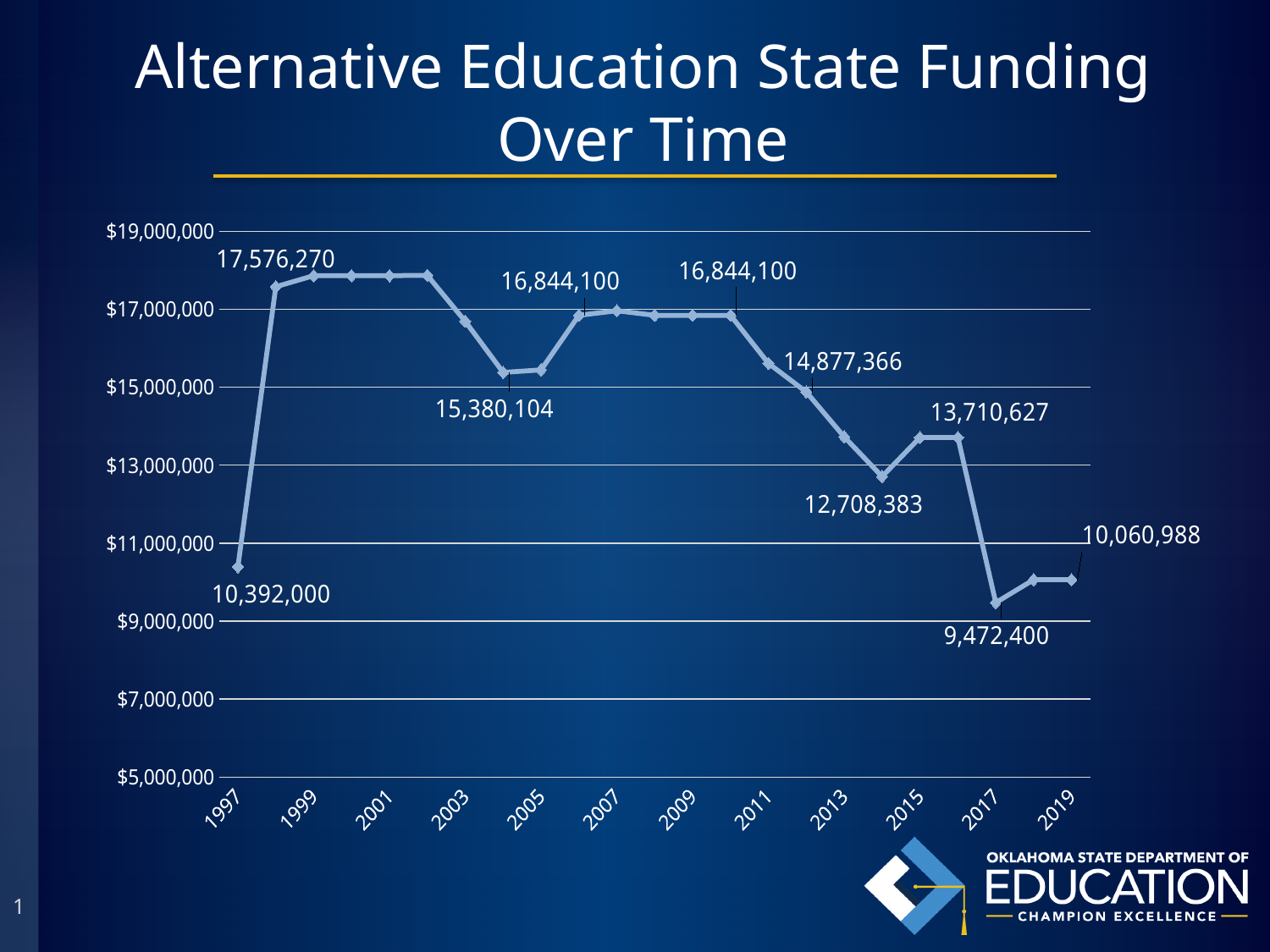
In which year does the funding reach its lowest point? 2017 What type of chart is shown on the slide? Line chart What is the difference between the 2019 value and the 2017 value? 588,588 What is the highest funding value labeled on the chart? 17,576,270 Is the value for 2013 greater or less than $15,000,000? less How many year labels are shown on the x axis? 12 What is the funding value for 2017? 9,472,400 What is the funding value for 2019? 10,060,988 Which year has the larger funding value, 1997 or 2019? 1997 What is the funding value for 1997? 10,392,000 Is the value for 2007 greater or less than $15,000,000? greater What is the title of the chart? Alternative Education State Funding Over Time